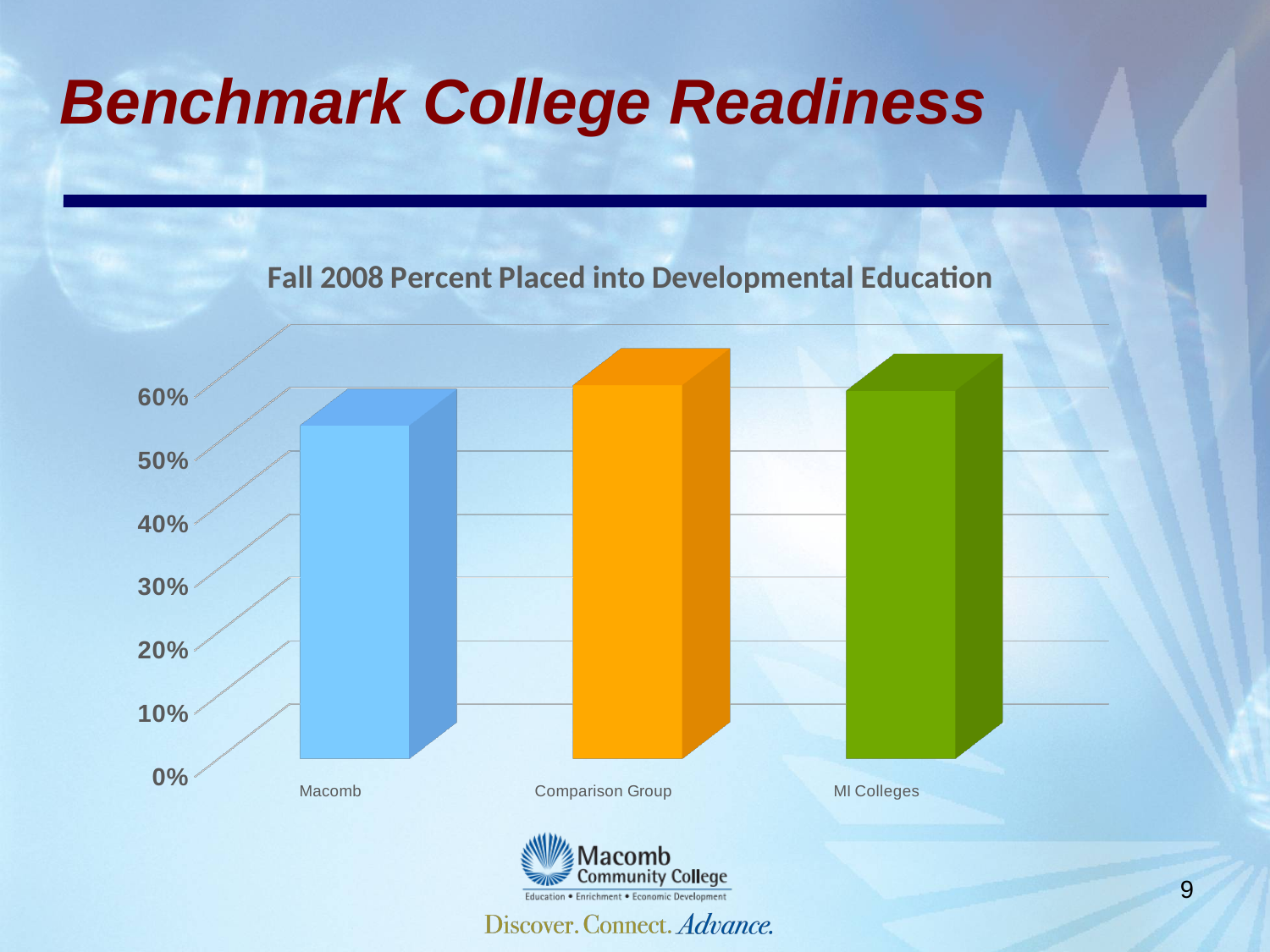
What colour is the bar for Comparison Group? orange What is the highest value labelled on the vertical axis? 60% What kind of chart is shown on the slide? bar chart Which is larger, the value for Macomb or the value for Comparison Group? Comparison Group Is the value for Macomb greater or less than 50%? greater Is the value for Macomb greater or less than 40%? greater Is the value for Comparison Group greater or less than 50%? greater How many categories are plotted in the chart? 3 Which is larger, the value for Macomb or the value for MI Colleges? MI Colleges Which category has the lowest percent placed into developmental education? Macomb What is the title of the chart? Fall 2008 Percent Placed into Developmental Education